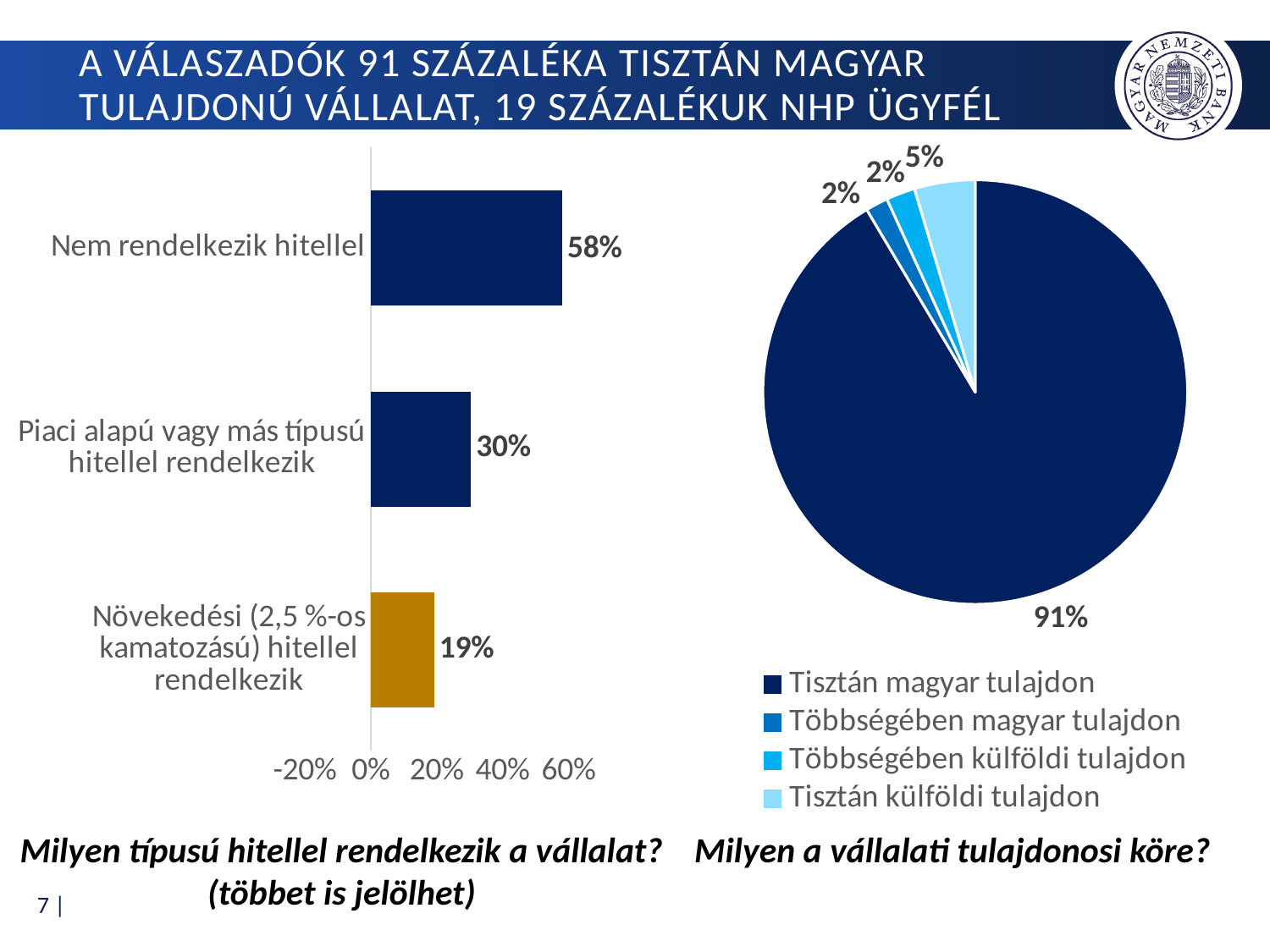
How many entries does the legend of the right pie chart list? 4 On the right pie chart, which slice is the largest? Tisztán magyar tulajdon On the right pie chart, what share does 'Tisztán külföldi tulajdon' have? 5% On the right pie chart, which is larger: 'Tisztán külföldi tulajdon' or 'Többségében magyar tulajdon'? Tisztán külföldi tulajdon On the left bar chart, which category has the highest value? Nem rendelkezik hitellel On the left bar chart, what is the value for 'Növekedési (2,5 %-os kamatozású) hitellel rendelkezik'? 19% What kind of chart is on the left side of the slide? bar chart On the right pie chart, what share does 'Tisztán magyar tulajdon' have? 91% On the left bar chart, what is the difference between 'Nem rendelkezik hitellel' and 'Piaci alapú vagy más típusú hitellel rendelkezik'? 28% On the left bar chart, what is the value for 'Nem rendelkezik hitellel'? 58% On the left bar chart, which category has the lowest value? Növekedési (2,5 %-os kamatozású) hitellel rendelkezik On the left bar chart, how many categories are shown? 3